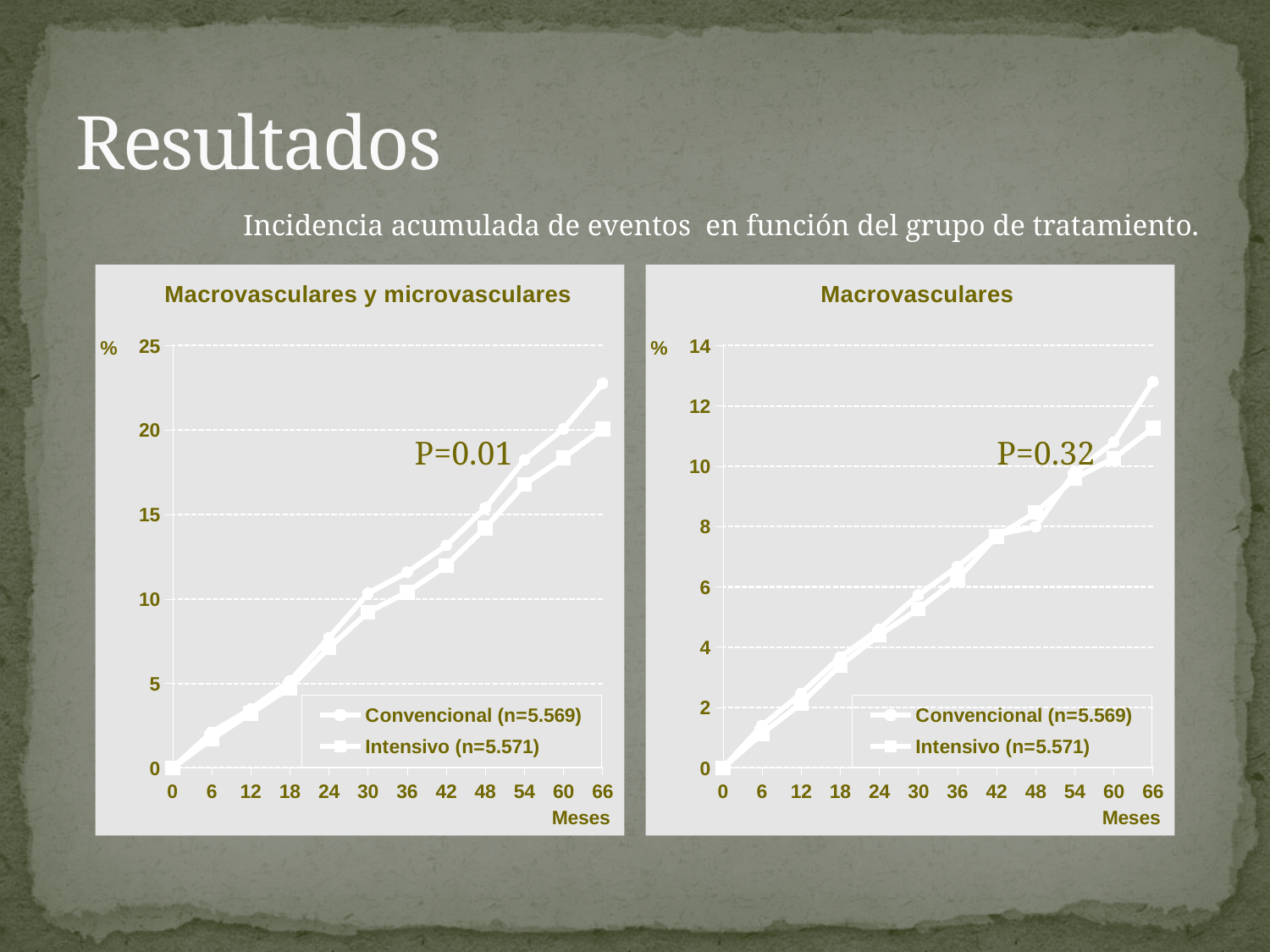
In the 'Macrovasculares' chart, is the value for Intensivo (n=5.571) at 66 months greater or less than 12? less In the 'Macrovasculares' chart, which series has the higher value at 66 months? Convencional (n=5.569) In the 'Macrovasculares y microvasculares' chart, is the value for Convencional (n=5.569) at 66 months greater or less than 20? greater What kind of chart is the 'Macrovasculares y microvasculares' chart? line chart What P value is shown on the 'Macrovasculares y microvasculares' chart? P=0.01 In the 'Macrovasculares' chart, do the values for Convencional (n=5.569) rise or fall as the months increase? rise How many time points are shown on the x axis of the 'Macrovasculares y microvasculares' chart? 12 In the 'Macrovasculares y microvasculares' chart, is the value for Intensivo (n=5.571) at 24 months greater or less than 10? less In the 'Macrovasculares y microvasculares' chart, which series has the higher value at 66 months? Convencional (n=5.569) How many series does the legend of the 'Macrovasculares' chart list? 2 What is the label of the x axis on the 'Macrovasculares' chart? Meses